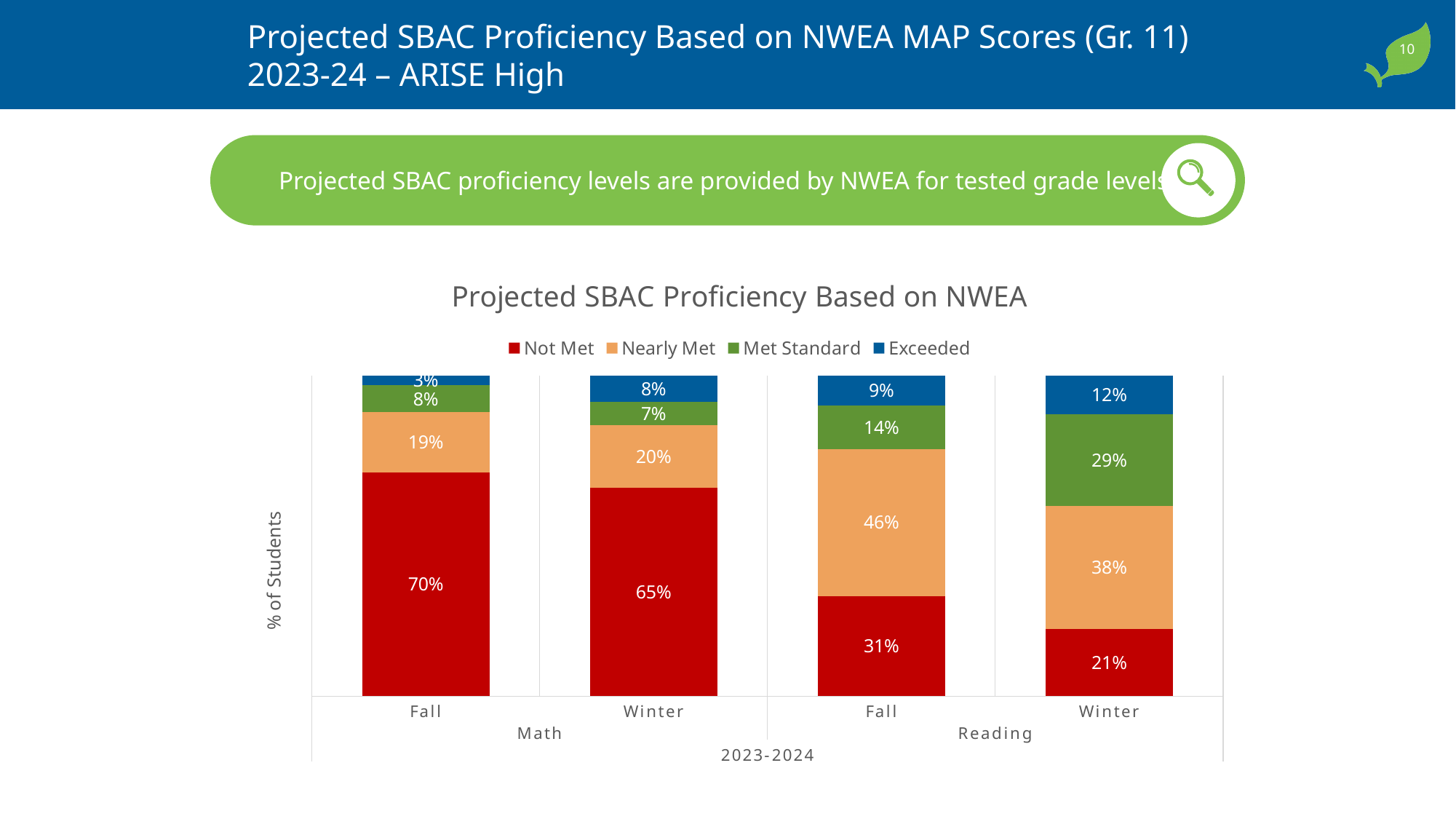
What is the difference between the Not Met percentage for Math Fall and Math Winter? 5% What kind of chart is shown? Stacked bar chart How many bars are shown in the chart? 4 What percentage of students are projected as Met Standard for Reading in Winter? 29% What is the combined percentage of Met Standard and Exceeded for Reading Winter? 41% Which bar has the lowest Exceeded percentage? Math Fall What percentage of students are projected as Exceeded for Reading in Fall? 9% Which is larger: the Nearly Met percentage for Reading Fall or Reading Winter? Reading Fall What percentage of students are projected as Not Met for Math in Fall? 70% How many series does the legend list? 4 Which bar has the highest Not Met percentage? Math Fall What percentage of students are projected as Nearly Met for Math in Winter? 20%